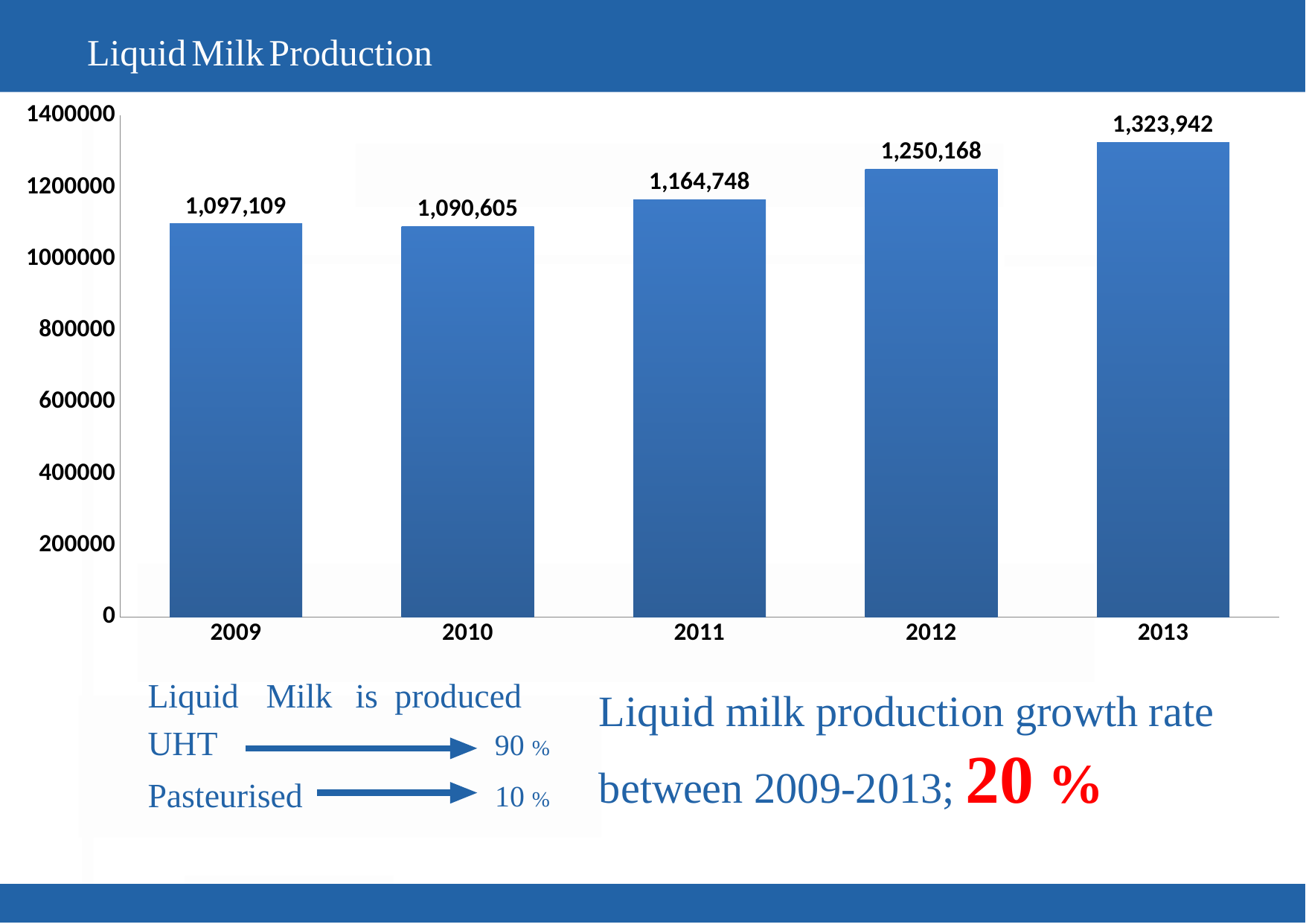
Which year has the larger production value, 2011 or 2012? 2012 How many years are shown on the chart? 5 Is the production value for 2012 greater or less than 1200000? greater Which year has the lowest liquid milk production? 2010 Which year has the highest liquid milk production? 2013 What is the liquid milk production value for 2010? 1,090,605 What is the difference between the 2013 and 2012 production values? 73,774 What is the liquid milk production value for 2013? 1,323,942 What is the liquid milk production value for 2011? 1,164,748 What is the difference between the 2009 and 2010 production values? 6,504 What is the title of the slide containing the chart? Liquid Milk Production What kind of chart is shown on the slide? Bar chart